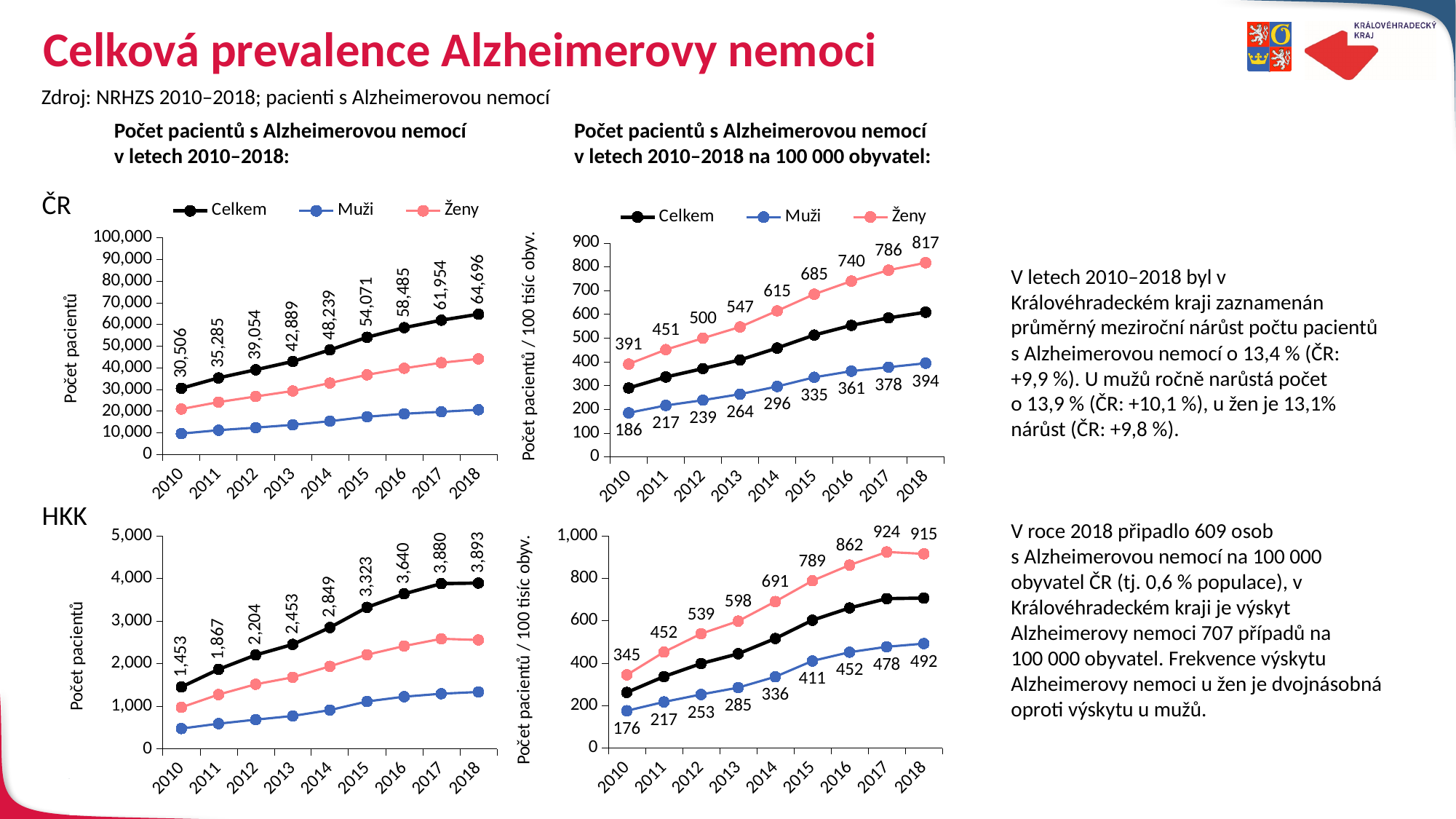
In the top-left chart (ČR, Počet pacientů), what is the Celkem value for 2018? 64,696 How many series does the legend of the top-left chart list? 3 In the top-right chart (ČR per 100 000 obyvatel), what is the Muži value for 2018? 394 In the bottom-right chart (HKK per 100 000 obyvatel), which is larger: the Ženy value for 2017 or for 2018? 2017 In the bottom-right chart (HKK per 100 000 obyvatel), is the Celkem value for 2018 greater or less than 600? greater In the top-right chart (ČR per 100 000 obyvatel), which year has the lowest Muži value? 2010 In the top-right chart (ČR per 100 000 obyvatel), what is the Ženy value for 2014? 615 In the bottom-right chart (HKK per 100 000 obyvatel), what is the Ženy value for 2017? 924 In the bottom-left chart (HKK, Počet pacientů), what is the Celkem value for 2015? 3,323 In the top-left chart (ČR, Počet pacientů), what is the difference between the Celkem values for 2018 and 2017? 2,742 In the top-left chart (ČR, Počet pacientů), what is the Celkem value for 2010? 30,506 In the bottom-left chart (HKK, Počet pacientů), which year has the highest Celkem value? 2018